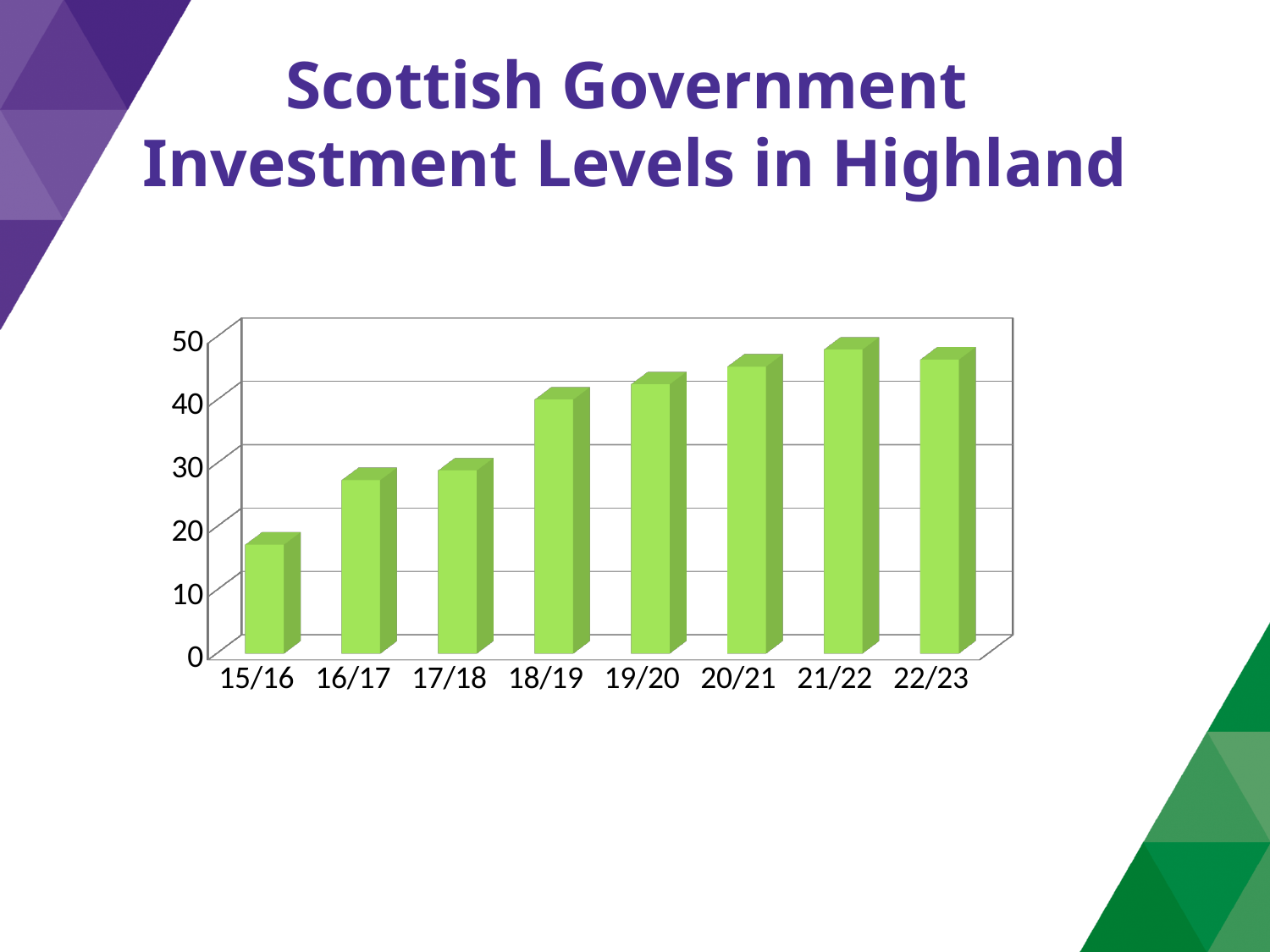
Is the value for 15/16 greater or less than 20? less Is the value for 16/17 greater or less than 20? greater Do the investment levels generally rise or fall from 15/16 to 21/22? rise Which year has the highest investment level in the chart? 21/22 How many years (categories) are shown on the x axis of the chart? 8 Is the value for 20/21 greater or less than 40? greater Which year has the lowest investment level in the chart? 15/16 What type of chart is shown on the slide? Bar chart What is the title of the slide containing the chart? Scottish Government Investment Levels in Highland Which is larger, the value for 15/16 or the value for 16/17? 16/17